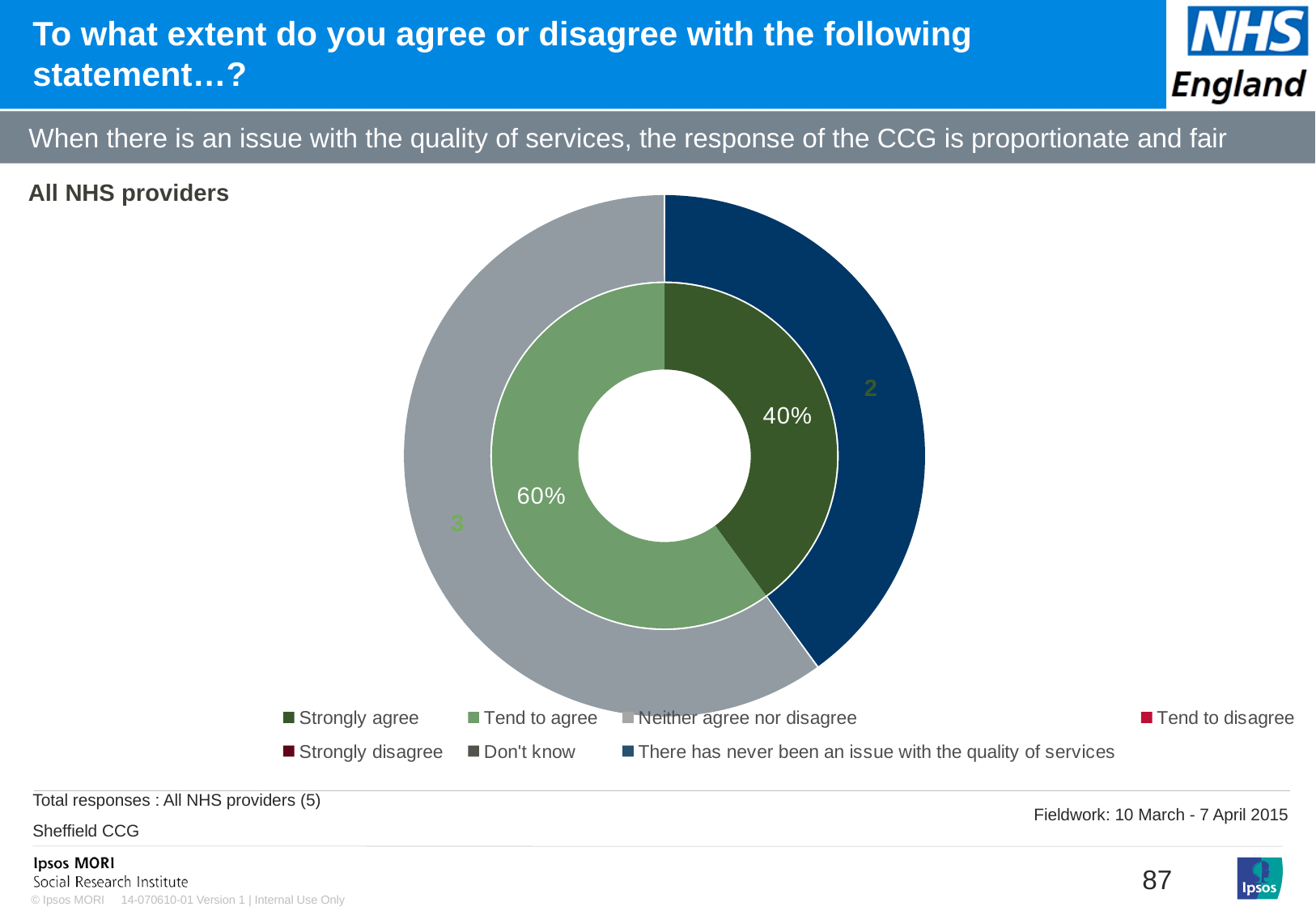
Which segment in the inner ring is larger, Strongly agree or Tend to agree? Tend to agree How many entries does the chart legend list? 7 What is the difference in percentage points between the Tend to agree and Strongly agree segments in the inner ring? 20 What is the total number of responses stated for All NHS providers? 5 What percentage is shown for the Strongly agree segment in the inner ring? 40% What kind of chart is shown on the slide? Doughnut chart How many segments are labelled with values in the inner ring? 2 What percentage is shown for the Tend to agree segment in the inner ring? 60% What is the total of the two values labelled in the outer ring? 5